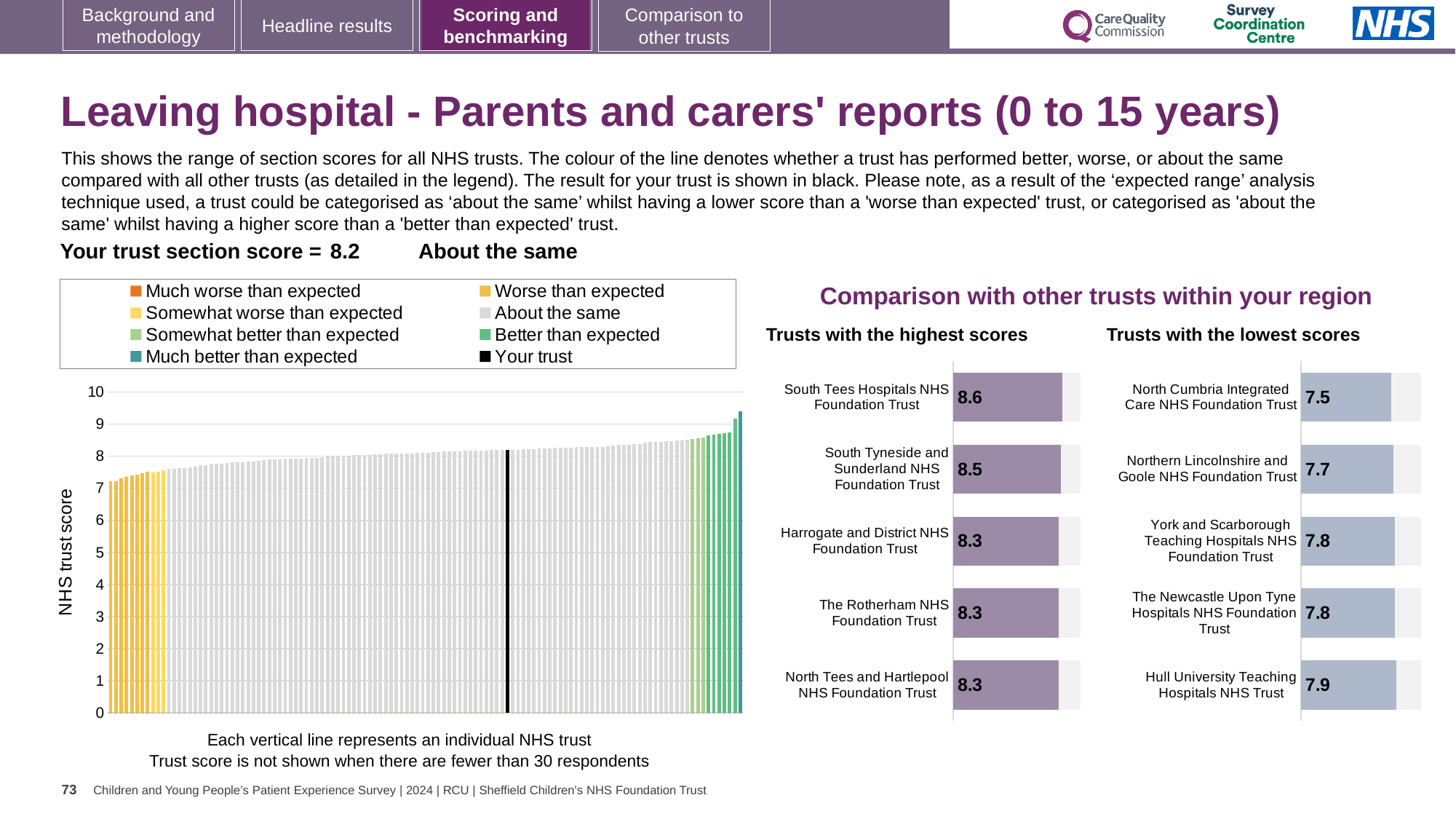
In the 'Trusts with the highest scores' chart, which trust has the highest score? South Tees Hospitals NHS Foundation Trust What kind of chart is the large chart on the left showing the range of NHS trust scores? Bar chart How many entries does the legend of the large chart on the left list? 8 In the 'Trusts with the lowest scores' chart, which has the larger score: Northern Lincolnshire and Goole NHS Foundation Trust or Hull University Teaching Hospitals NHS Trust? Hull University Teaching Hospitals NHS Trust In the 'Trusts with the lowest scores' chart, which trust has the lowest score? North Cumbria Integrated Care NHS Foundation Trust In the large chart on the left, is the value of the tallest bar greater or less than 9? greater How many trusts are listed in the 'Trusts with the lowest scores' chart? 5 In the 'Trusts with the highest scores' chart, what is the difference between the scores of South Tees Hospitals NHS Foundation Trust and Harrogate and District NHS Foundation Trust? 0.3 In the 'Trusts with the lowest scores' chart, what is the score for North Cumbria Integrated Care NHS Foundation Trust? 7.5 In the 'Trusts with the highest scores' chart, what is the score for South Tees Hospitals NHS Foundation Trust? 8.6 In the 'Trusts with the lowest scores' chart, what is the score for Hull University Teaching Hospitals NHS Trust? 7.9 In the 'Trusts with the highest scores' chart, what is the score for South Tyneside and Sunderland NHS Foundation Trust? 8.5